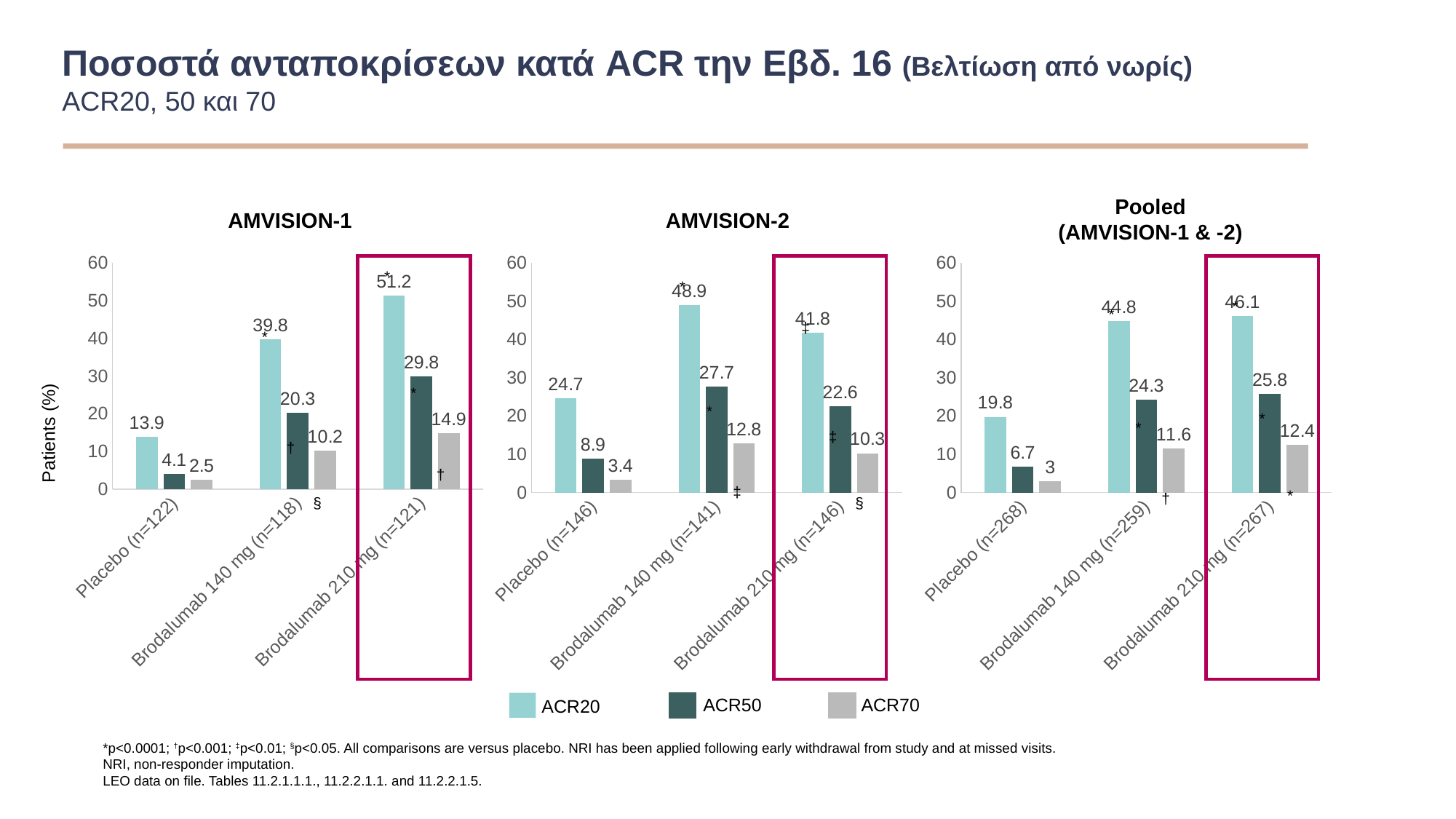
In the AMVISION-1 chart, which category has the highest ACR20 value? Brodalumab 210 mg (n=121) In the AMVISION-2 chart, which is larger: the ACR20 value for Brodalumab 140 mg (n=141) or for Brodalumab 210 mg (n=146)? Brodalumab 140 mg (n=141) What is the label of the y axis? Patients (%) What kind of chart is the Pooled (AMVISION-1 & -2) chart? Bar chart In the AMVISION-1 chart, is the ACR50 value for Brodalumab 210 mg (n=121) greater or less than 20? greater In the Pooled (AMVISION-1 & -2) chart, what is the ACR70 value for Placebo (n=268)? 3 How many categories are shown on the x axis of the AMVISION-1 chart? 3 In the AMVISION-1 chart, what is the ACR20 value for Brodalumab 210 mg (n=121)? 51.2 In the AMVISION-2 chart, which category has the lowest ACR70 value? Placebo (n=146) In the Pooled (AMVISION-1 & -2) chart, what is the difference between the ACR20 values for Brodalumab 210 mg (n=267) and Placebo (n=268)? 26.3 How many series does the legend list? 3 In the AMVISION-2 chart, what is the ACR50 value for Brodalumab 140 mg (n=141)? 27.7